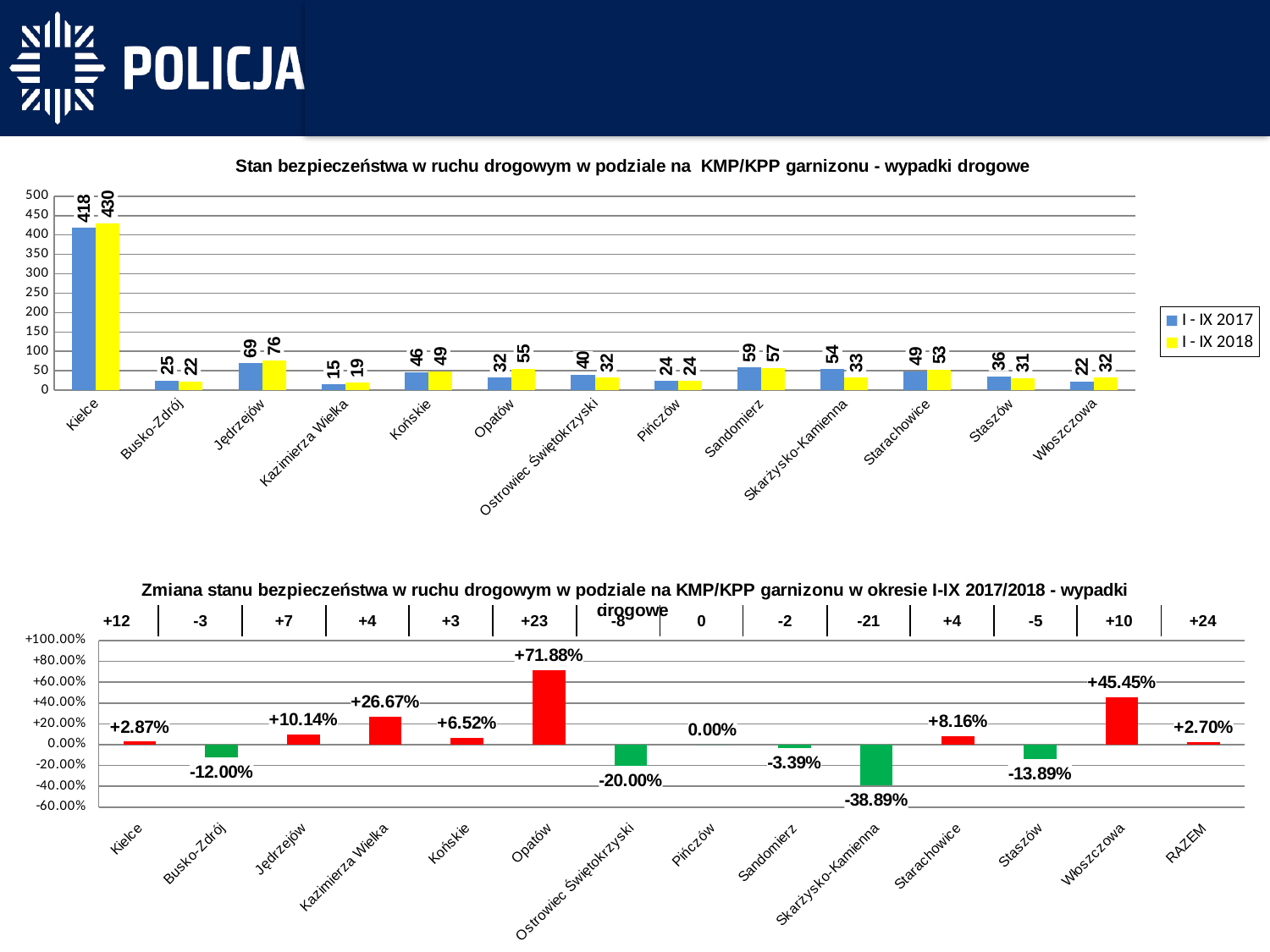
In the bottom chart, which category has the lowest percentage change? Skarżysko-Kamienna In the bottom chart, what is the percentage change shown for RAZEM? +2.70% How many series does the legend of the top chart list? 2 In the top chart, which category has the lowest value in the I - IX 2017 series? Kazimierza Wielka In the top chart, what is the value for Opatów in the I - IX 2017 series? 32 In the top chart, what is the difference between the I - IX 2018 and I - IX 2017 values for Skarżysko-Kamienna? 21 What kind of chart is the top chart? bar chart How many categories are shown on the x axis of the top chart? 13 In the top chart, what is the value for Kielce in the I - IX 2018 series? 430 In the bottom chart, what is the percentage change shown for Opatów? +71.88% In the top chart, which category has the highest value in the I - IX 2018 series? Kielce In the top chart, which is larger for Sandomierz: the I - IX 2017 value or the I - IX 2018 value? I - IX 2017